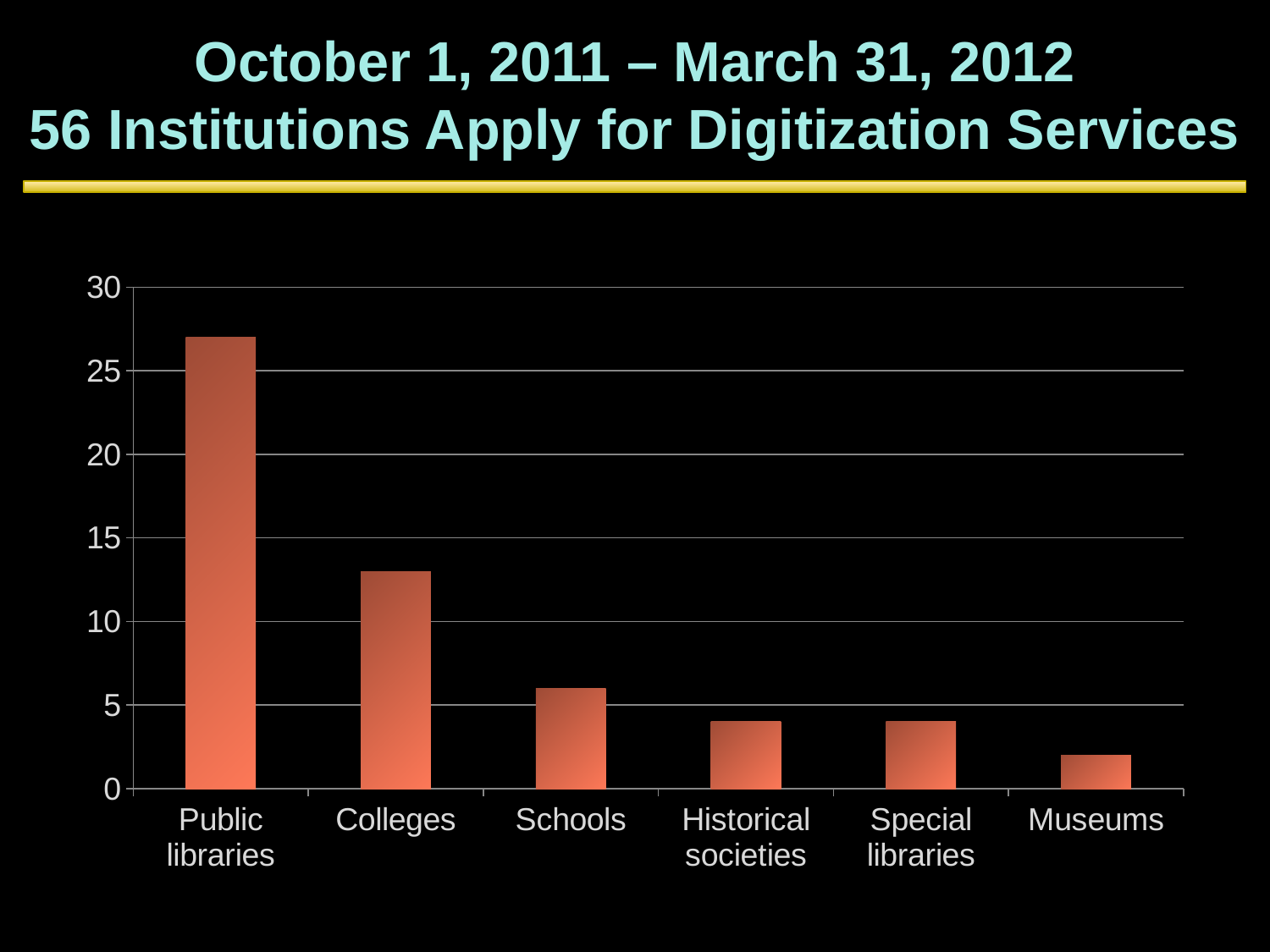
Which category has the highest bar? Public libraries Which is larger, the value for Colleges or the value for Schools? Colleges Which is larger, the value for Historical societies or the value for Museums? Historical societies Is the value for Public libraries greater or less than 25? greater Is the value for Colleges greater or less than 10? greater Is the value for Museums greater or less than 5? less How many categories are shown on the x axis? 6 Do the bar values generally rise or fall from left to right along the x axis? Fall What kind of chart is shown on the slide? Bar chart Which category has the lowest bar? Museums